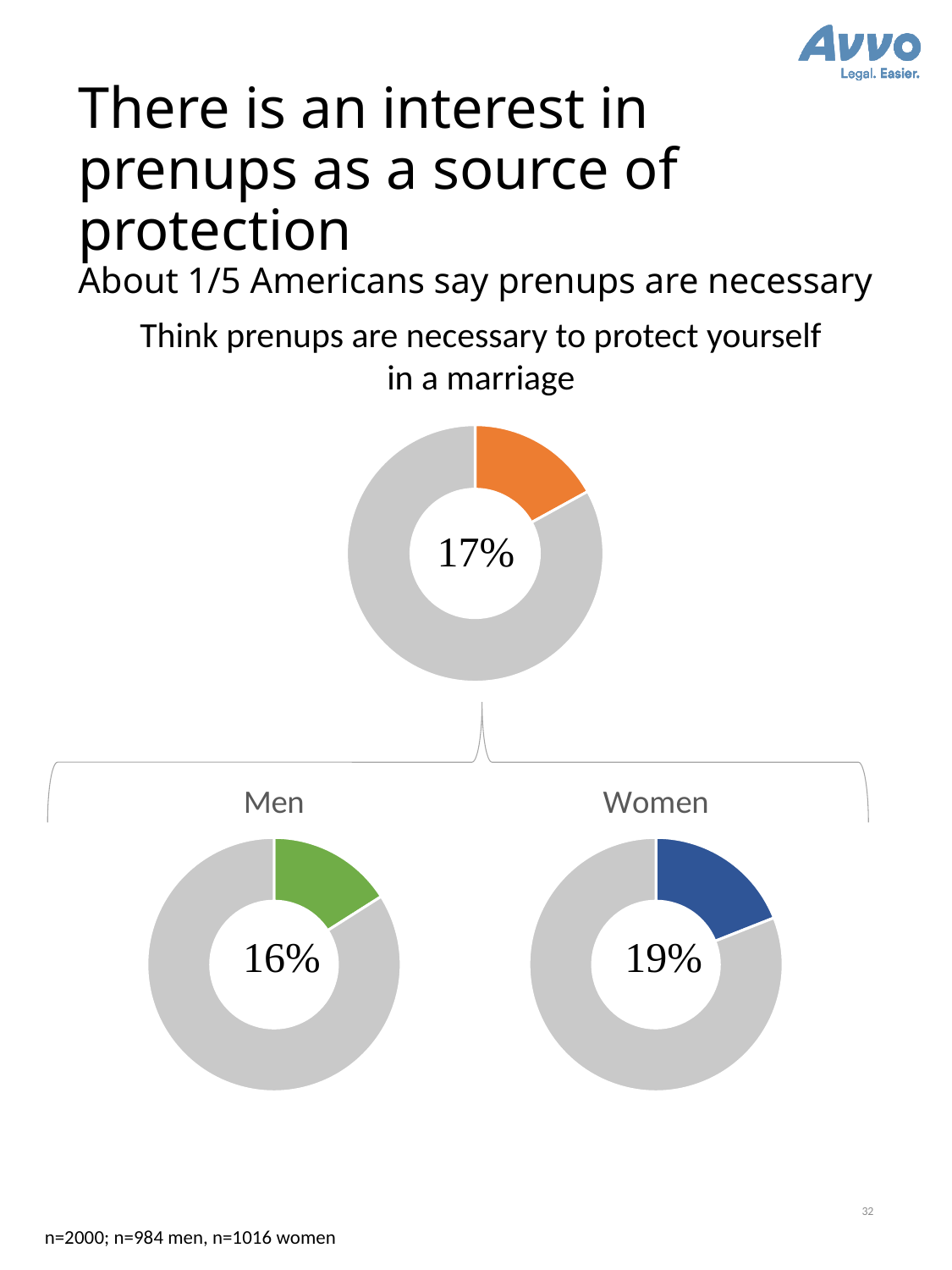
In the top donut chart, what percentage think prenups are necessary to protect yourself in a marriage? 17% What colour is the highlighted slice in the Women donut chart? Blue What kind of chart is used to show the percentages on this slide? Donut (pie) chart What is the title above the top donut chart? Think prenups are necessary to protect yourself in a marriage In the bottom-left donut chart for Men, what percentage think prenups are necessary? 16% How many donut charts are shown on the slide? 3 Comparing the Men and Women donut charts, which group has the higher percentage saying prenups are necessary? Women Of the Men and Women donut charts, which shows the lower percentage? Men What is the difference in percentage points between the Women chart (19%) and the Men chart (16%)? 3 percentage points In the bottom-right donut chart for Women, what percentage think prenups are necessary? 19% In the top donut chart, is the highlighted value greater or less than 20%? less